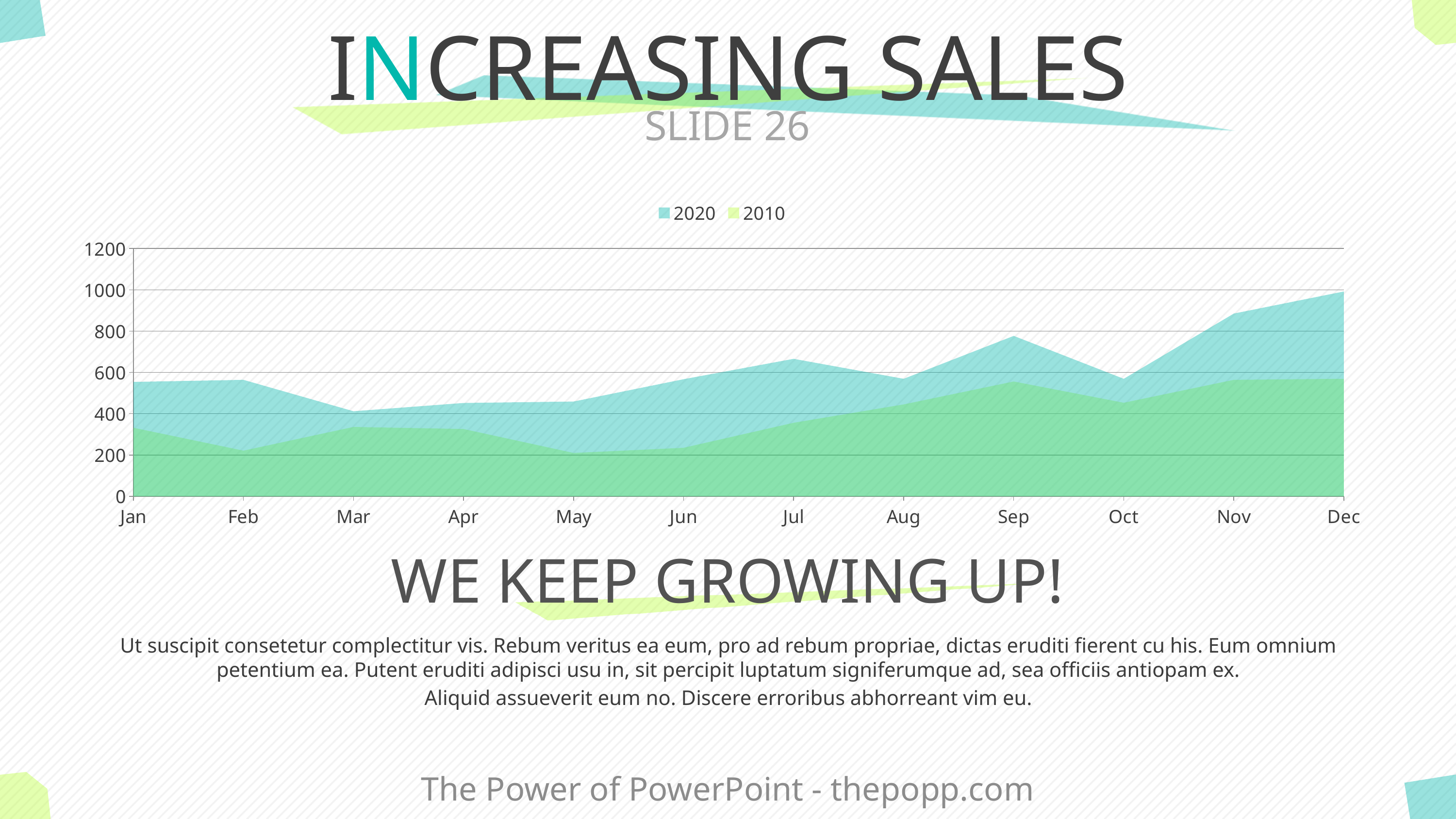
Is the value for 2020 in Mar greater or less than 600? less Is the value for 2010 in May greater or less than 400? less How many months are shown along the x axis? 12 Does the 2020 series overall rise or fall from Jan to Dec? Rise Is the value for 2010 in Sep greater or less than 400? greater How many series does the legend list? 2 Which series has the larger value in Dec, 2020 or 2010? 2020 In which month does the 2020 series reach its highest value? Dec What kind of chart is shown on the slide? Area chart What are the two entries in the chart legend? 2020 and 2010